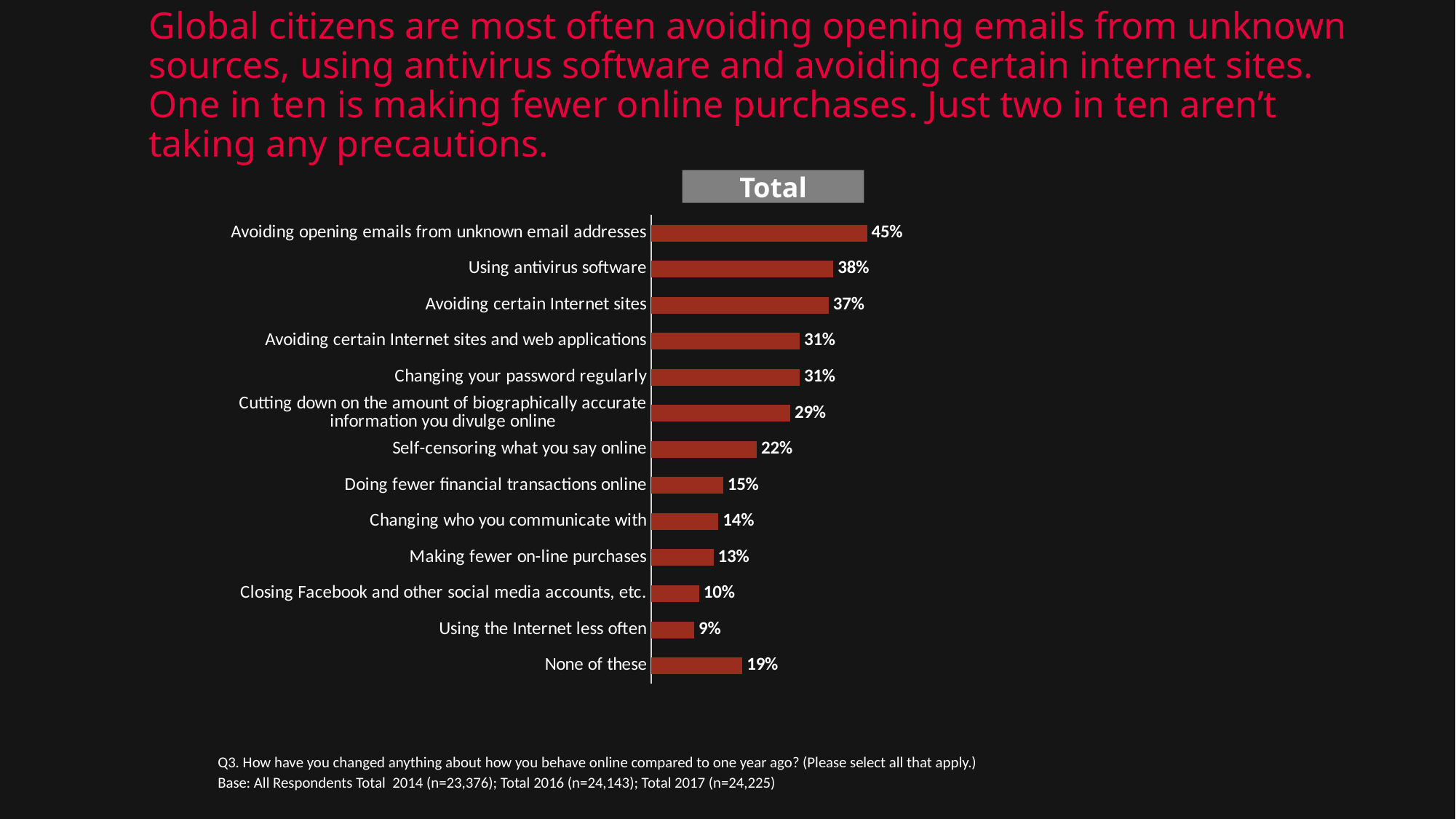
Which category has the highest value? Avoiding opening emails from unknown email addresses Which category has the lowest value? Using the Internet less often What is the label shown in the grey box above the chart? Total How many categories are shown in the chart? 13 Which is larger: 'Self-censoring what you say online' or 'Doing fewer financial transactions online'? Self-censoring what you say online What is the value for 'Using antivirus software'? 38% What percentage of respondents report avoiding opening emails from unknown email addresses? 45% What percentage selected 'None of these'? 19% What is the difference between 'Using antivirus software' and 'Avoiding certain Internet sites'? 1% What is the value for 'Making fewer on-line purchases'? 13% What is the difference between 'Avoiding opening emails from unknown email addresses' and 'None of these'? 26% What kind of chart is shown on the slide? Bar chart